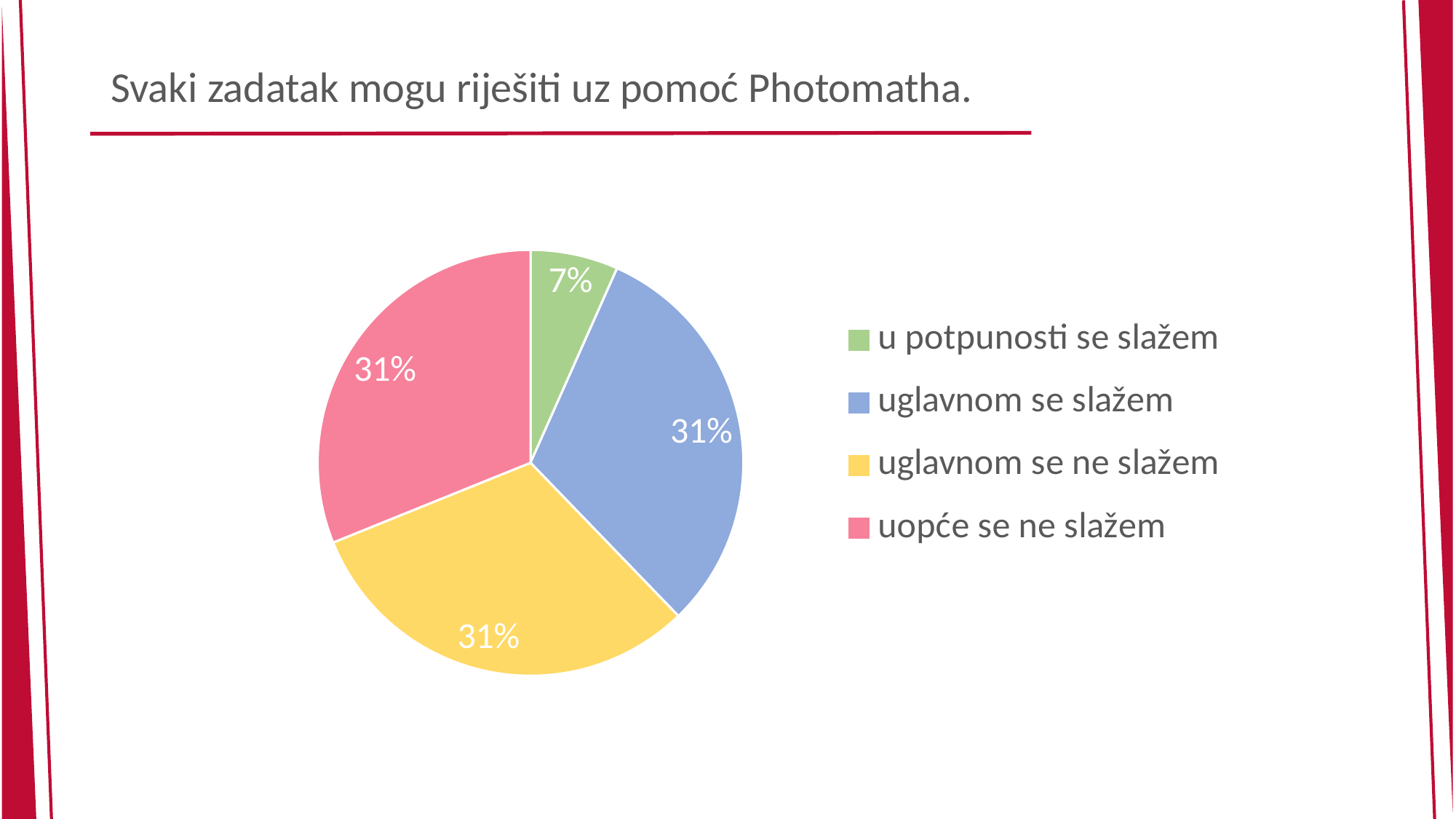
Which colour represents "uopće se ne slažem" in the pie chart? pink How many entries does the legend list? 4 What share of the pie does "uglavnom se ne slažem" have? 31% What share of the pie does "uopće se ne slažem" have? 31% What is the difference in percentage points between the "uopće se ne slažem" slice and the "u potpunosti se slažem" slice? 24 percentage points What kind of chart is shown on the slide? pie chart Which category has the smallest slice of the pie? u potpunosti se slažem How many slices does the pie chart have? 4 What share of the pie does "u potpunosti se slažem" have? 7% Which is larger: the slice for "u potpunosti se slažem" or the slice for "uglavnom se slažem"? uglavnom se slažem What is the title of the slide above the chart? Svaki zadatak mogu riješiti uz pomoć Photomatha.